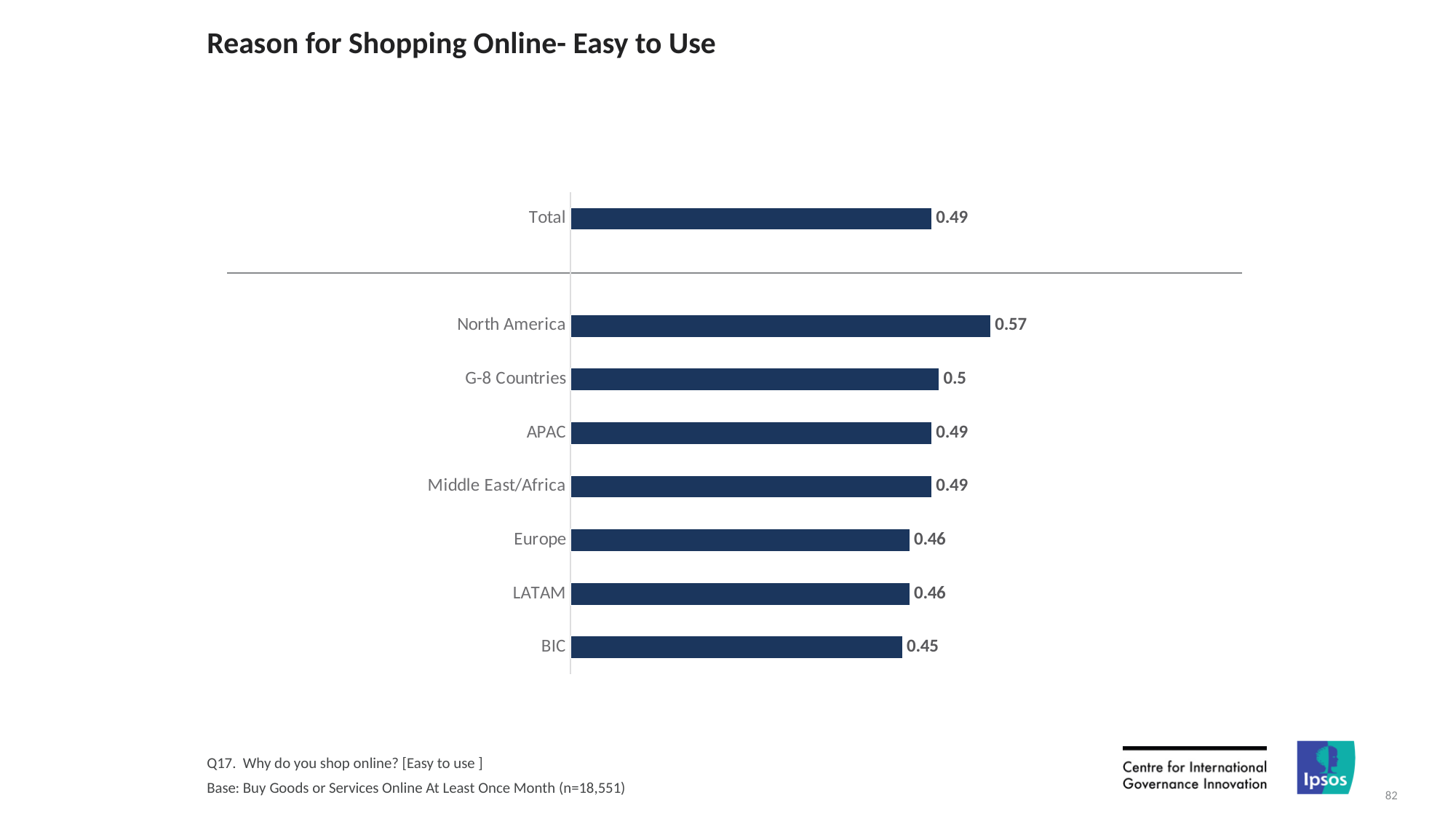
What is the difference between the values for North America and Total? 0.08 What is the value for BIC? 0.45 Which category has the highest value? North America What is the value for G-8 Countries? 0.5 What kind of chart is shown on the slide? Bar chart What is the value for Total? 0.49 What is the value for North America? 0.57 What is the difference between the values for North America and BIC? 0.12 What is the value for Europe? 0.46 Which is larger, the value for G-8 Countries or the value for LATAM? G-8 Countries How many categories are shown in the chart? 8 Which category has the lowest value? BIC